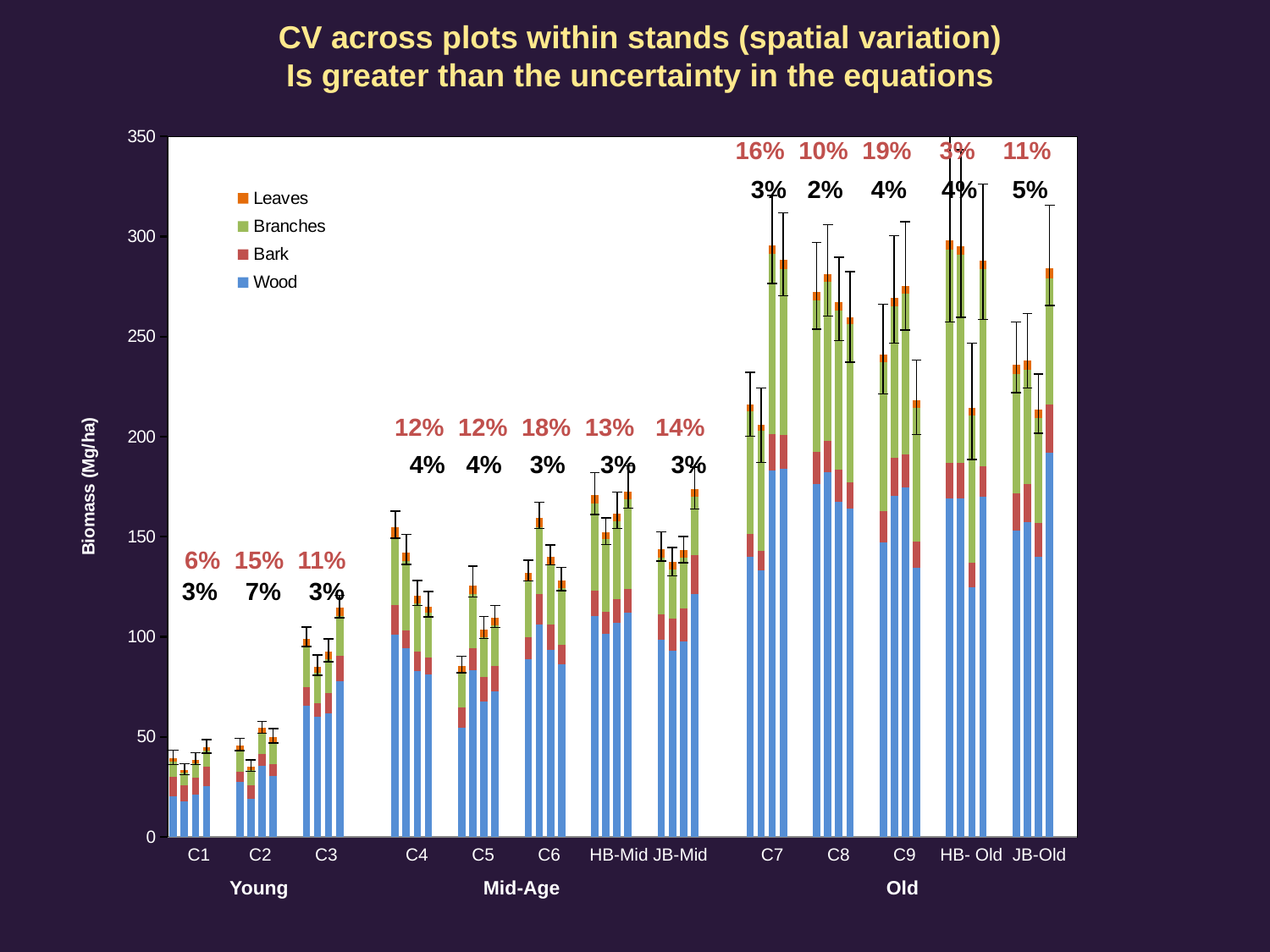
How many series does the legend list? 4 What is the red CV percentage shown above the C9 stand? 19% Are the total biomass values for the C8 bars greater or less than 250 Mg/ha? greater What is the label of the y axis? Biomass (Mg/ha) Which stand has the lowest red CV percentage? HB- Old Are the total biomass values for the C1 bars greater or less than 50 Mg/ha? less What type of chart is shown on the slide? Stacked bar chart How many stand categories are labelled along the x axis? 13 What is the black percentage shown above the C2 stand? 7% Which stand has taller stacked bars, C1 or C8? C8 What are the four series listed in the legend? Leaves, Branches, Bark, Wood Which stand has the highest red CV percentage? C9